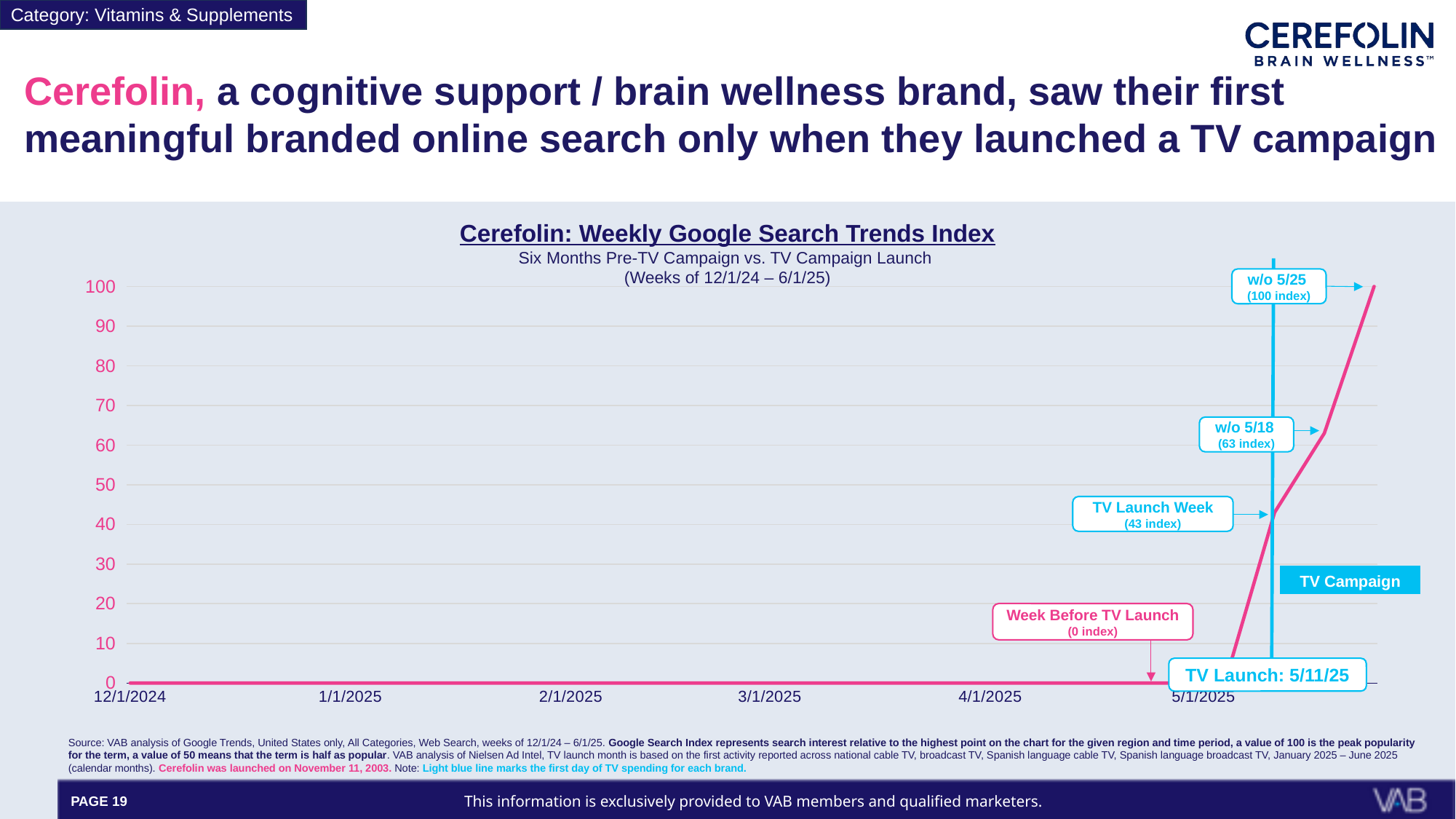
What kind of chart is shown on the slide? Line chart What is the difference in index between the week of 5/18 and the TV Launch Week? 20 What is the search index value for the Week Before TV Launch? 0 index What is the search index value for the week of 5/18? 63 index What is the search index value for the TV Launch Week? 43 index Which week has the highest search index value? w/o 5/25 What is the title of the chart? Cerefolin: Weekly Google Search Trends Index What is the TV launch date shown on the chart? 5/11/25 Which is larger, the index for the TV Launch Week or the index for the week of 5/18? w/o 5/18 What is the search index value for the week of 5/25? 100 index What is the difference in index between the week of 5/25 and the week of 5/18? 37 Does the search index rise or fall after the TV launch on 5/11/25? Rise